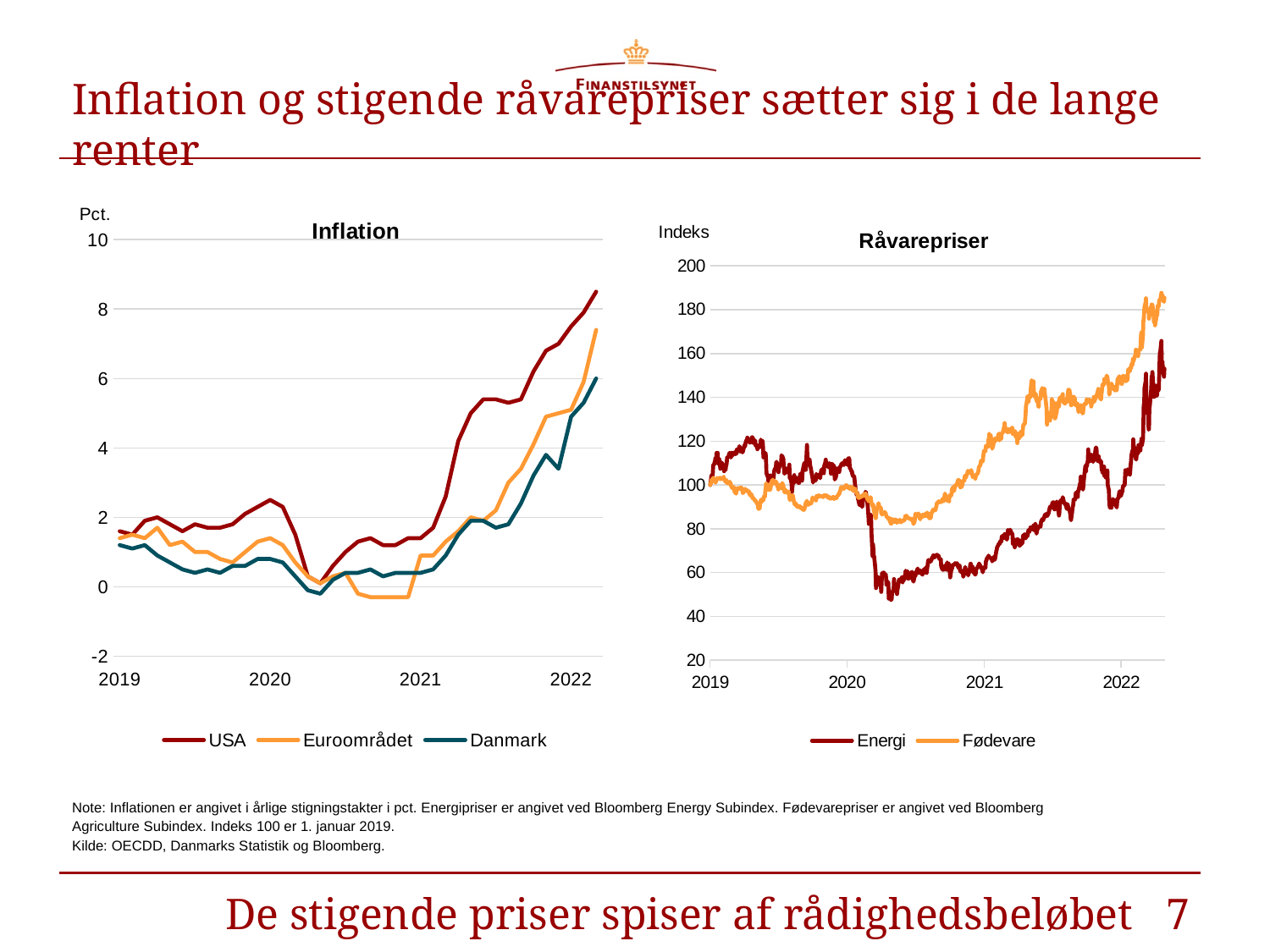
In the Råvarepriser chart, is the lowest value of the Energi series in 2020 greater or less than 60? less What kind of chart is the Inflation chart? line chart In the Inflation chart, does the USA series rise or fall between 2021 and 2022? rise What kind of chart is the Råvarepriser chart? line chart What is the unit label on the y axis of the Råvarepriser chart? Indeks How many series does the legend of the Inflation chart list? 3 In the Inflation chart, which series has the highest value at the end of the period in 2022? USA In the Råvarepriser chart, which series is higher at the end of the period in 2022, Energi or Fødevare? Fødevare What are the legend entries of the Inflation chart? USA, Euroområdet, Danmark In the Råvarepriser chart, is the value for Fødevare at the end of the period in 2022 greater or less than 160? greater How many series does the legend of the Råvarepriser chart list? 2 In the Inflation chart, is the value for USA at the end of the period in 2022 greater or less than 8? greater